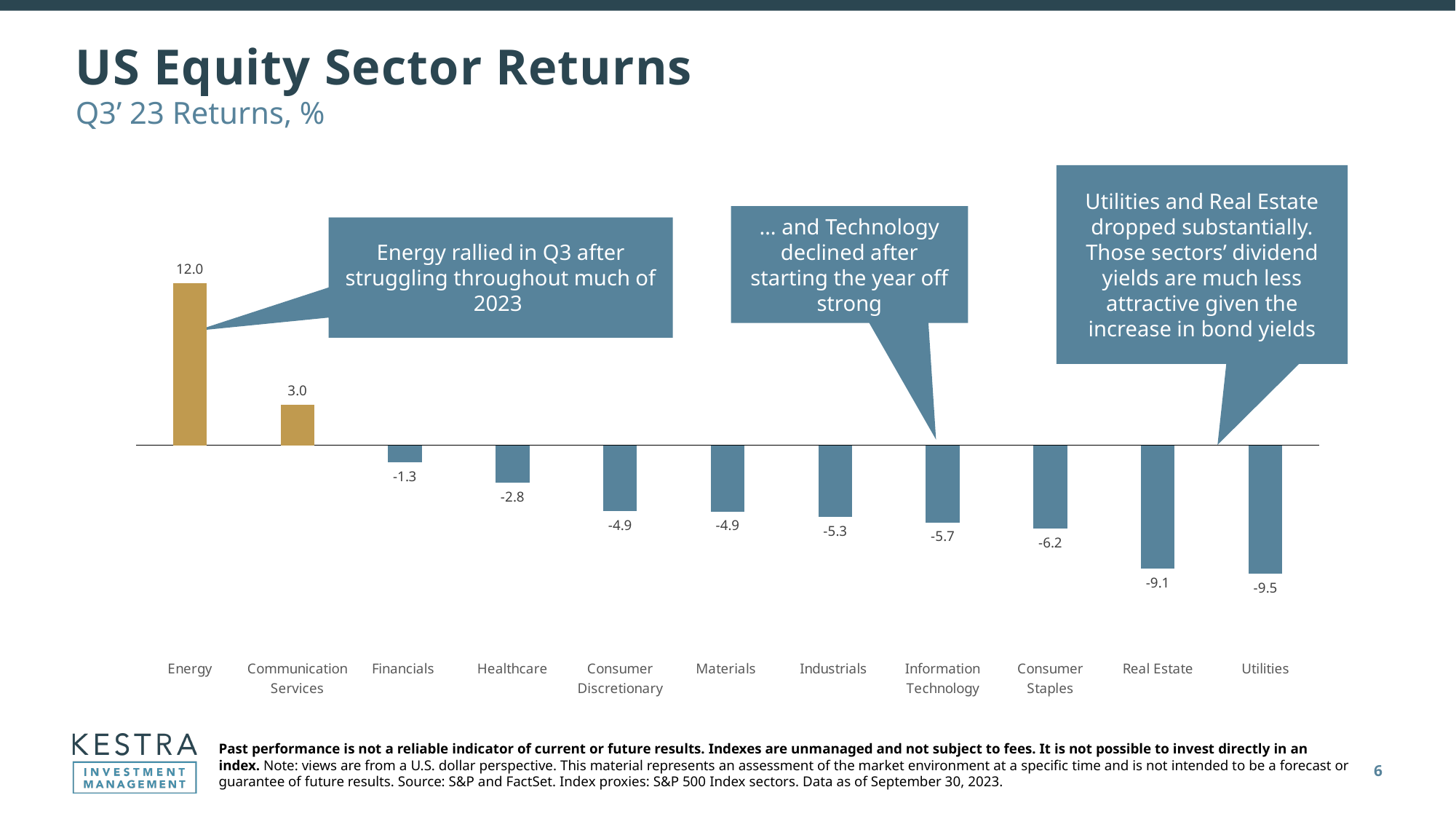
What is the subtitle of the chart? Q3' 23 Returns, % What is the Q3 2023 return for Energy? 12.0 What is the difference between the Energy return and the Communication Services return? 9.0 What is the difference between the Real Estate return and the Utilities return? 0.4 What type of chart is shown on the slide? Bar chart Which sector has the lowest Q3 2023 return? Utilities How many sectors are shown in the chart? 11 What is the Q3 2023 return for Information Technology? -5.7 Which sector has a higher return, Financials or Healthcare? Financials Do the returns generally rise or fall moving from left to right across the sectors? Fall What is the Q3 2023 return for Utilities? -9.5 Which sector has the highest Q3 2023 return? Energy